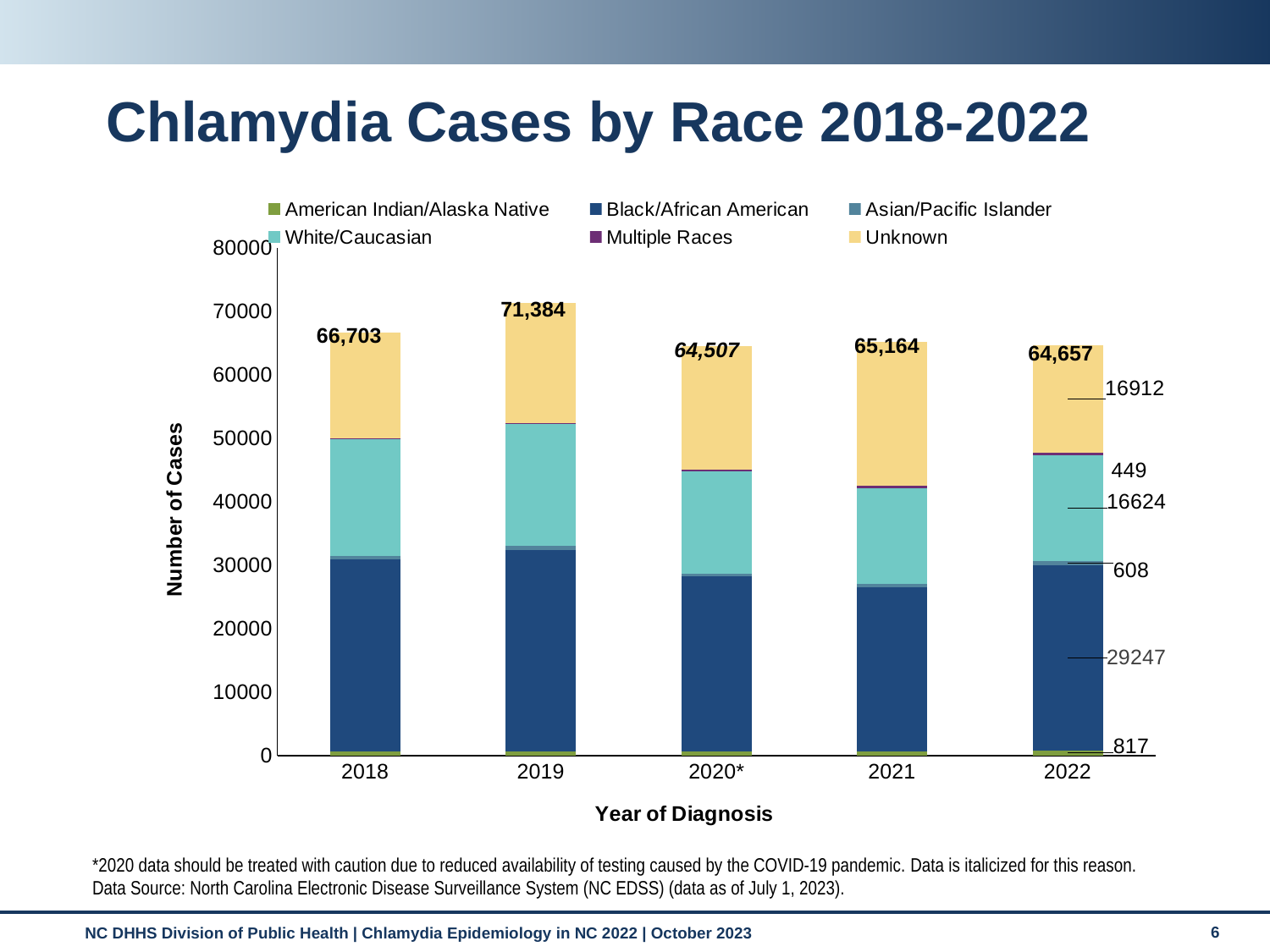
Which year has the lowest total number of chlamydia cases? 2020* How many Black/African American chlamydia cases are labeled for 2022? 29247 What kind of chart is shown on the slide? Stacked bar chart Which year has the highest total number of chlamydia cases? 2019 How many Unknown-race chlamydia cases are labeled for 2022? 16912 How many race categories does the legend list? 6 What is the total number of chlamydia cases shown for 2020*? 64,507 What is the difference between the total cases in 2019 and 2018? 4,681 Which year has more total cases, 2021 or 2022? 2021 How many American Indian/Alaska Native cases are labeled for 2022? 817 What is the total number of chlamydia cases shown for 2019? 71,384 How many years are shown on the x axis? 5